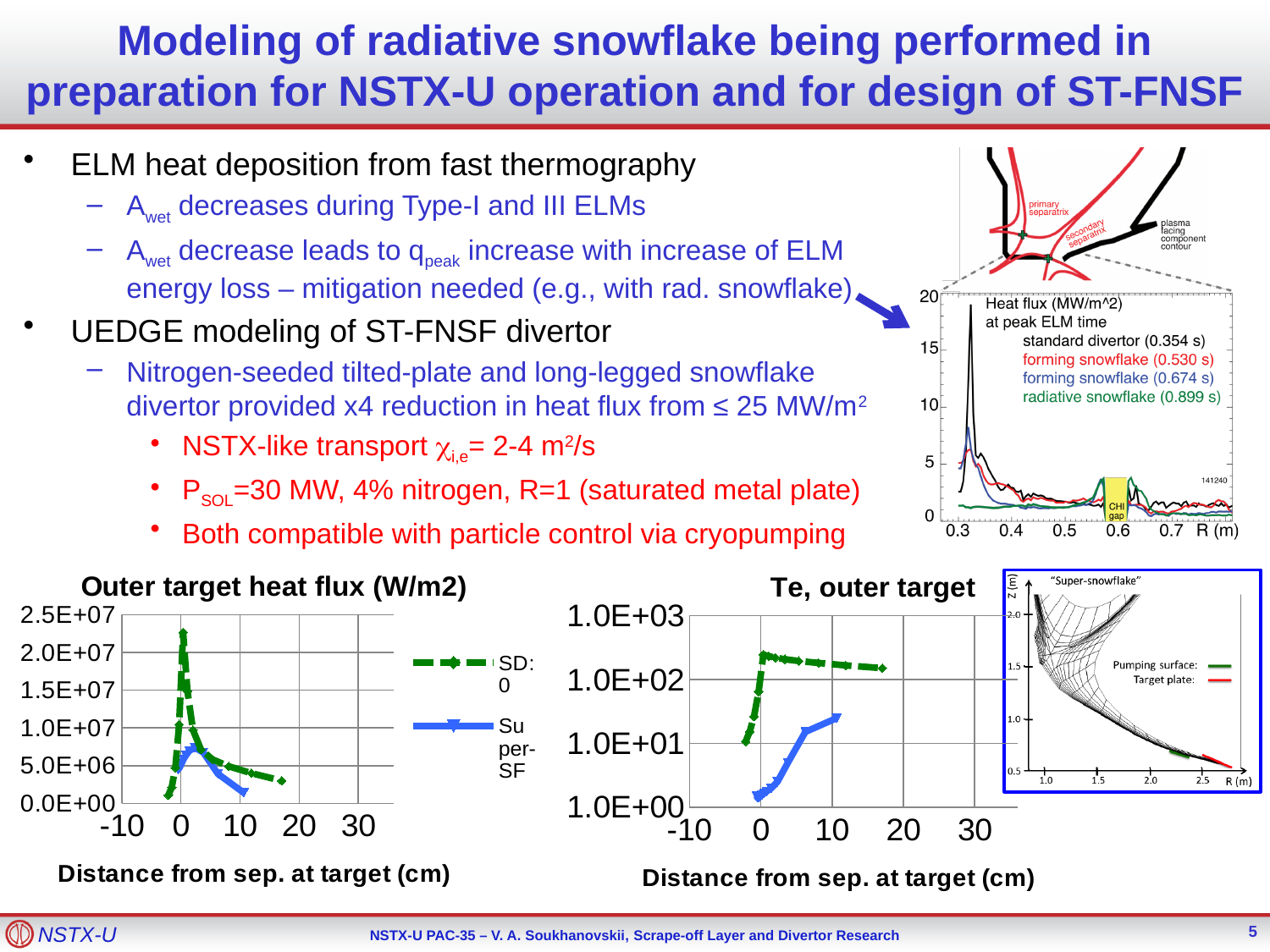
In the bottom-left chart titled "Outer target heat flux (W/m2)", which series reaches the higher peak heat flux, SD: 0 or Super-SF? SD: 0 In the bottom-left chart titled "Outer target heat flux (W/m2)", is the peak value of the Super-SF series greater or less than 1.0E+07? less In the top-right chart of heat flux at peak ELM time, which series has the highest peak heat flux? standard divertor (0.354 s) In the top-right chart of heat flux at peak ELM time, is the peak value of the standard divertor (0.354 s) series greater or less than 15? greater In the chart titled "Te, outer target", what is the highest value shown on the y axis? 1.0E+03 In the chart titled "Te, outer target", is the peak value of the green dashed series greater or less than 1.0E+02? greater In the bottom-left chart titled "Outer target heat flux (W/m2)", what is the x-axis label? Distance from sep. at target (cm) In the bottom-left chart titled "Outer target heat flux (W/m2)", what kind of chart is it? line chart In the bottom-left chart titled "Outer target heat flux (W/m2)", how many series does the legend list? 2 In the top-right chart of heat flux at peak ELM time, how many series are listed in the legend? 4